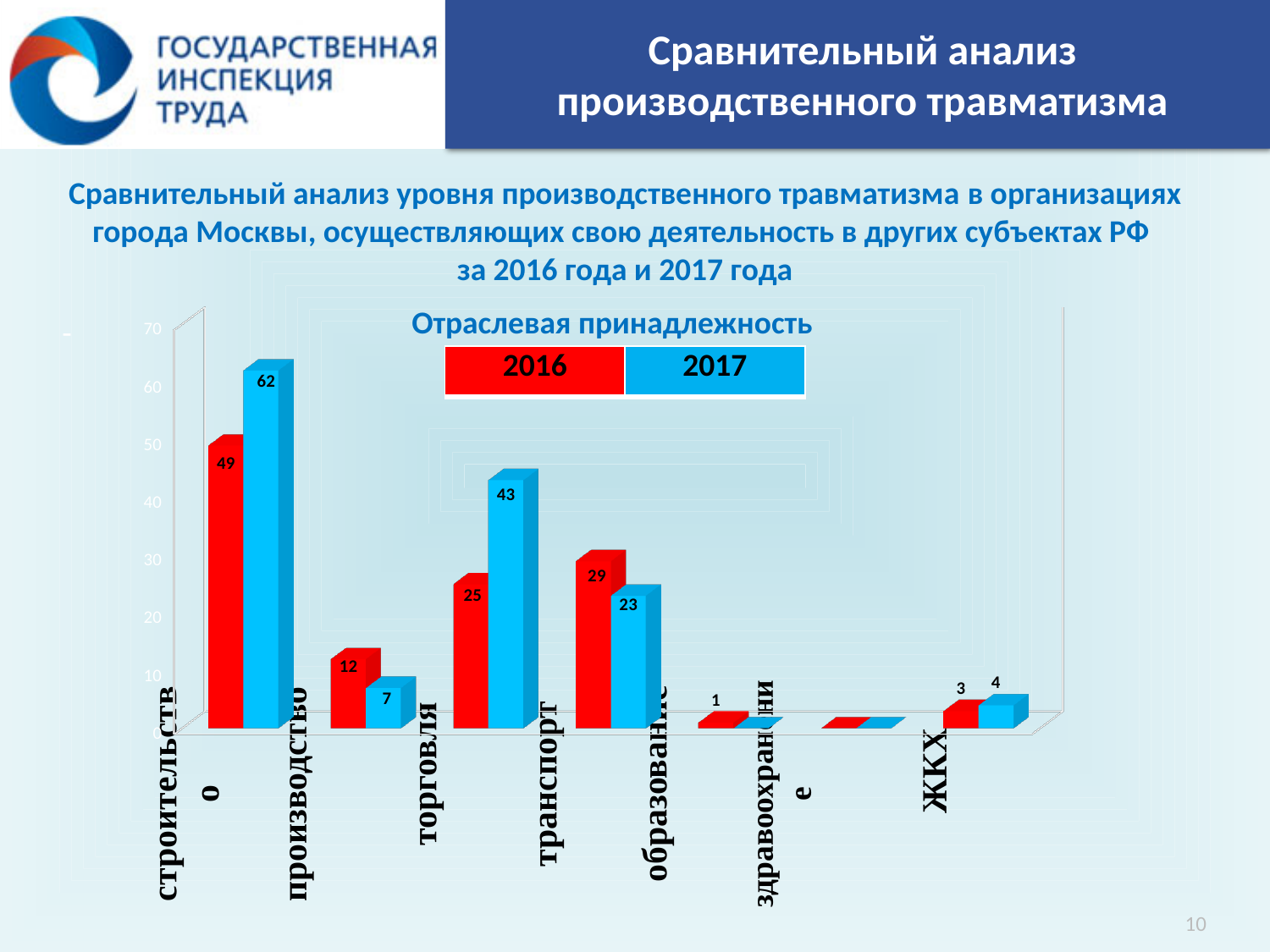
What type of chart is shown on the slide? bar chart Which category has the highest value in 2017? строительство Which category has the highest value in 2016? строительство What is the value for ЖКХ in 2017? 4 For транспорт, which year has the larger value, 2016 or 2017? 2016 How many categories are shown on the x axis? 7 What is the difference between the 2017 and 2016 values for строительство? 13 How many series does the legend list? 2 What is the value for торговля in 2017? 43 What is the value for строительство in 2016? 49 For производство, which year has the larger value, 2016 or 2017? 2016 What is the difference between the 2017 and 2016 values for торговля? 18